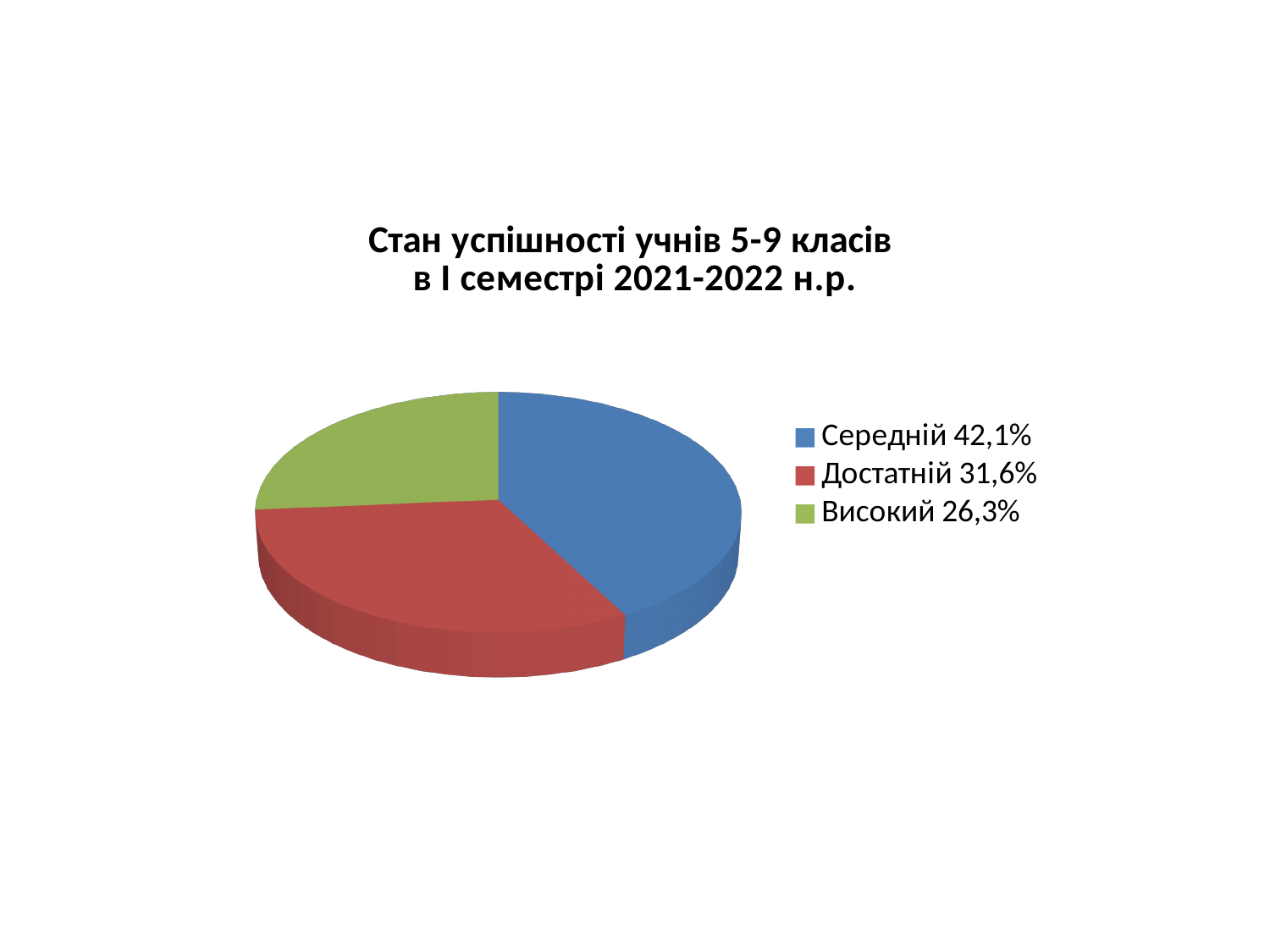
What is the difference between the shares for Середній and Достатній? 10,5% Which is larger, the share for Достатній or the share for Високий? Достатній Which category has the smallest share of the pie? Високий What colour is the slice for Високий? green How many slices does the pie chart have? 3 What share of the pie is labelled Середній? 42,1% What share of the pie is labelled Достатній? 31,6% What share of the pie is labelled Високий? 26,3% What kind of chart is shown on the slide? pie chart What is the title of the chart? Стан успішності учнів 5-9 класів в І семестрі 2021-2022 н.р. Which category has the largest share of the pie? Середній What is the difference between the shares for Середній and Високий? 15,8%